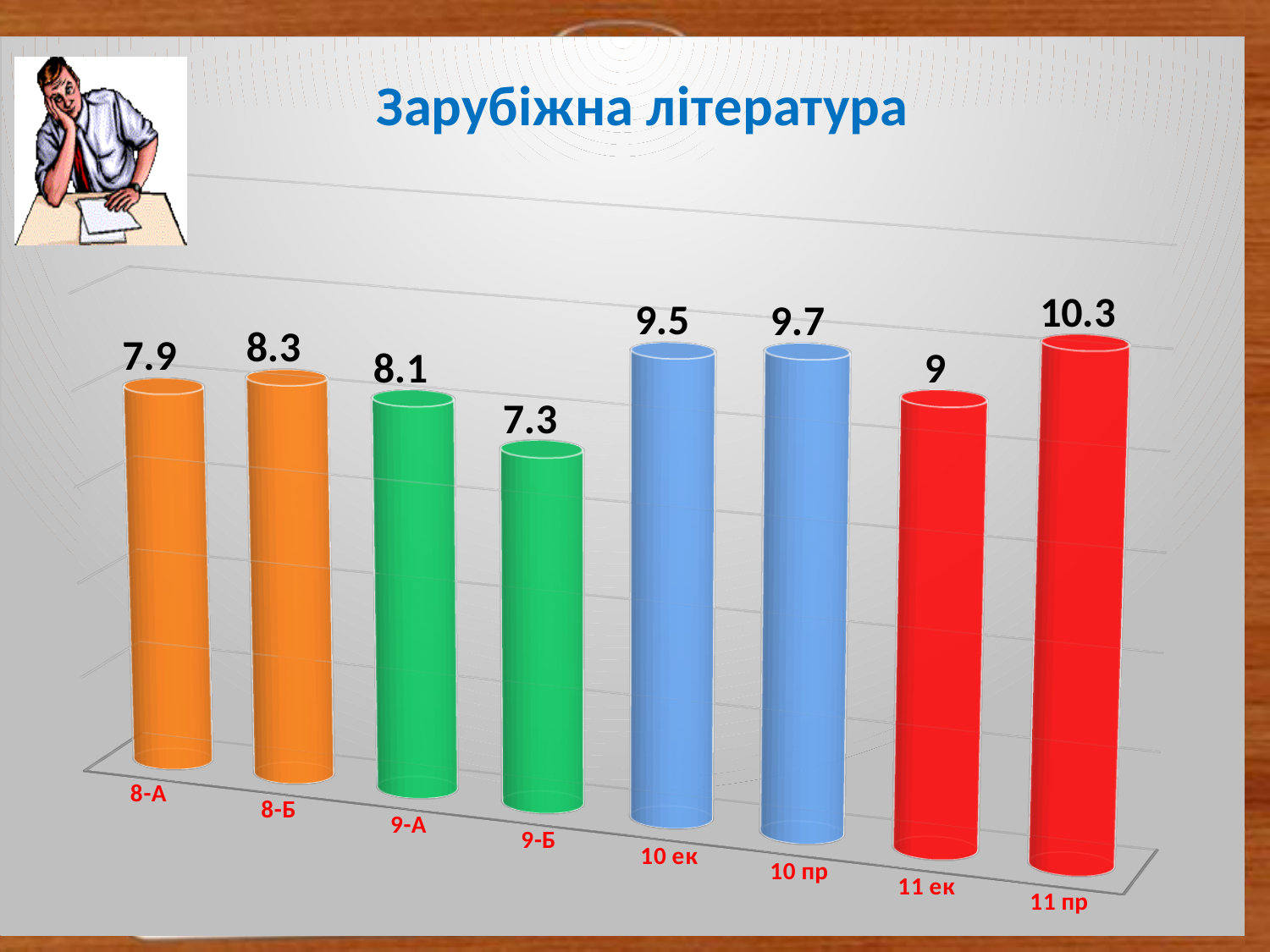
What is the title of the chart? Зарубіжна література Which category has the highest value? 11 пр What is the difference between the values for 8-Б and 8-A? 0.4 Which is larger, the value for 9-A or the value for 10 ек? 10 ек What is the value for 8-A? 7.9 What colour are the bars for 10 ек and 10 пр? blue How many categories are shown on the chart? 8 What is the difference between the values for 11 пр and 9-Б? 3 Which category has the lowest value? 9-Б What is the value for 11 ек? 9 What kind of chart is shown on the slide? bar chart What is the value for 10 пр? 9.7